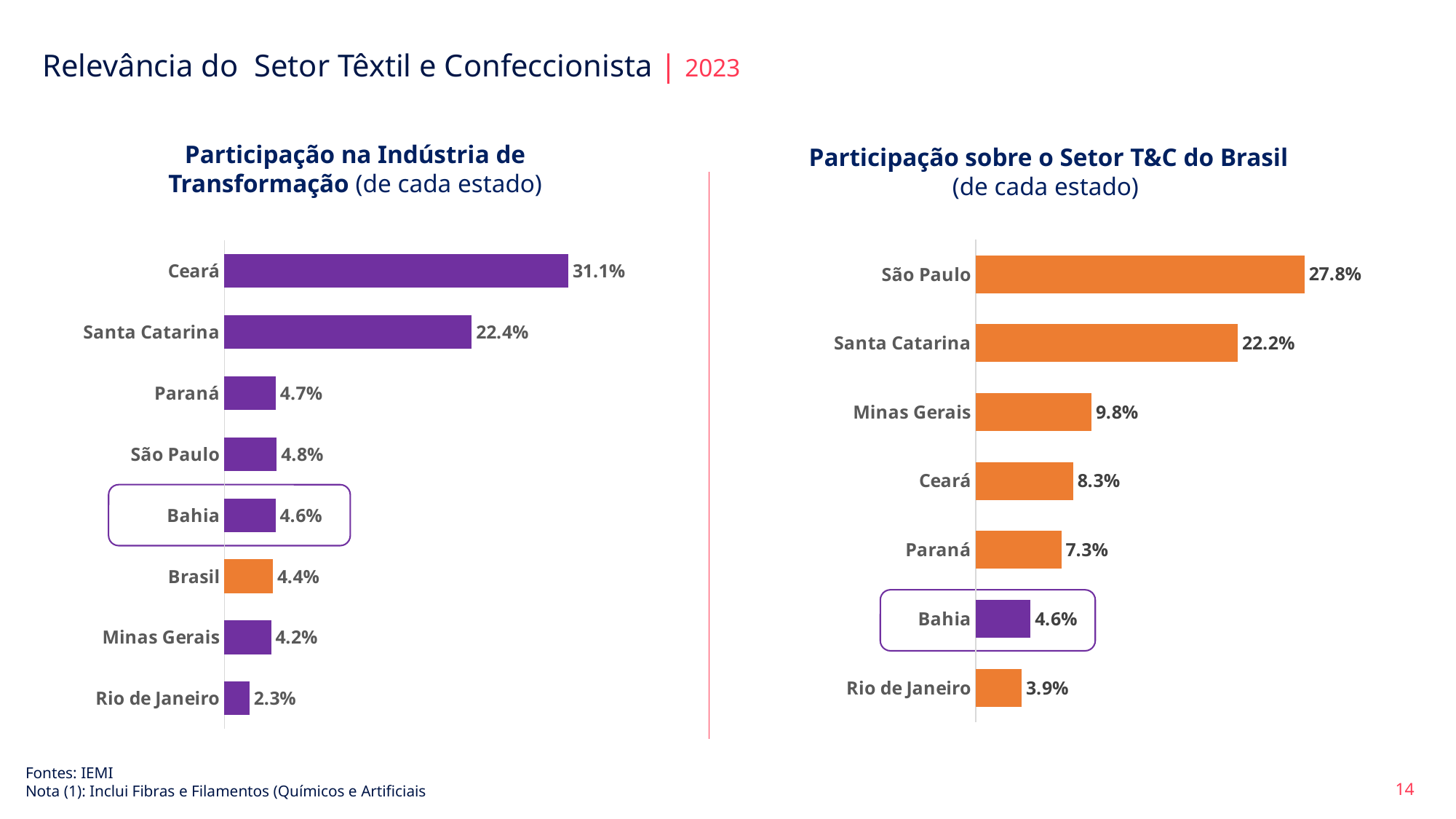
In the right chart 'Participação sobre o Setor T&C do Brasil', how many categories are shown? 7 In the left chart 'Participação na Indústria de Transformação', what is the value for Brasil? 4.4% In the left chart 'Participação na Indústria de Transformação', which category has the lowest value? Rio de Janeiro What type of chart is the right chart 'Participação sobre o Setor T&C do Brasil'? Bar chart In the left chart 'Participação na Indústria de Transformação', what is the difference between Ceará and Santa Catarina? 8.7% In the right chart 'Participação sobre o Setor T&C do Brasil', what is the value for Minas Gerais? 9.8% In the right chart 'Participação sobre o Setor T&C do Brasil', what is the difference between São Paulo and Santa Catarina? 5.6% In the right chart 'Participação sobre o Setor T&C do Brasil', which category has the highest value? São Paulo In the left chart 'Participação na Indústria de Transformação', how many categories are shown? 8 In the right chart 'Participação sobre o Setor T&C do Brasil', which bar is coloured purple instead of orange? Bahia In the left chart 'Participação na Indústria de Transformação', what is the value for Ceará? 31.1% In the right chart 'Participação sobre o Setor T&C do Brasil', which is larger, Ceará or Paraná? Ceará